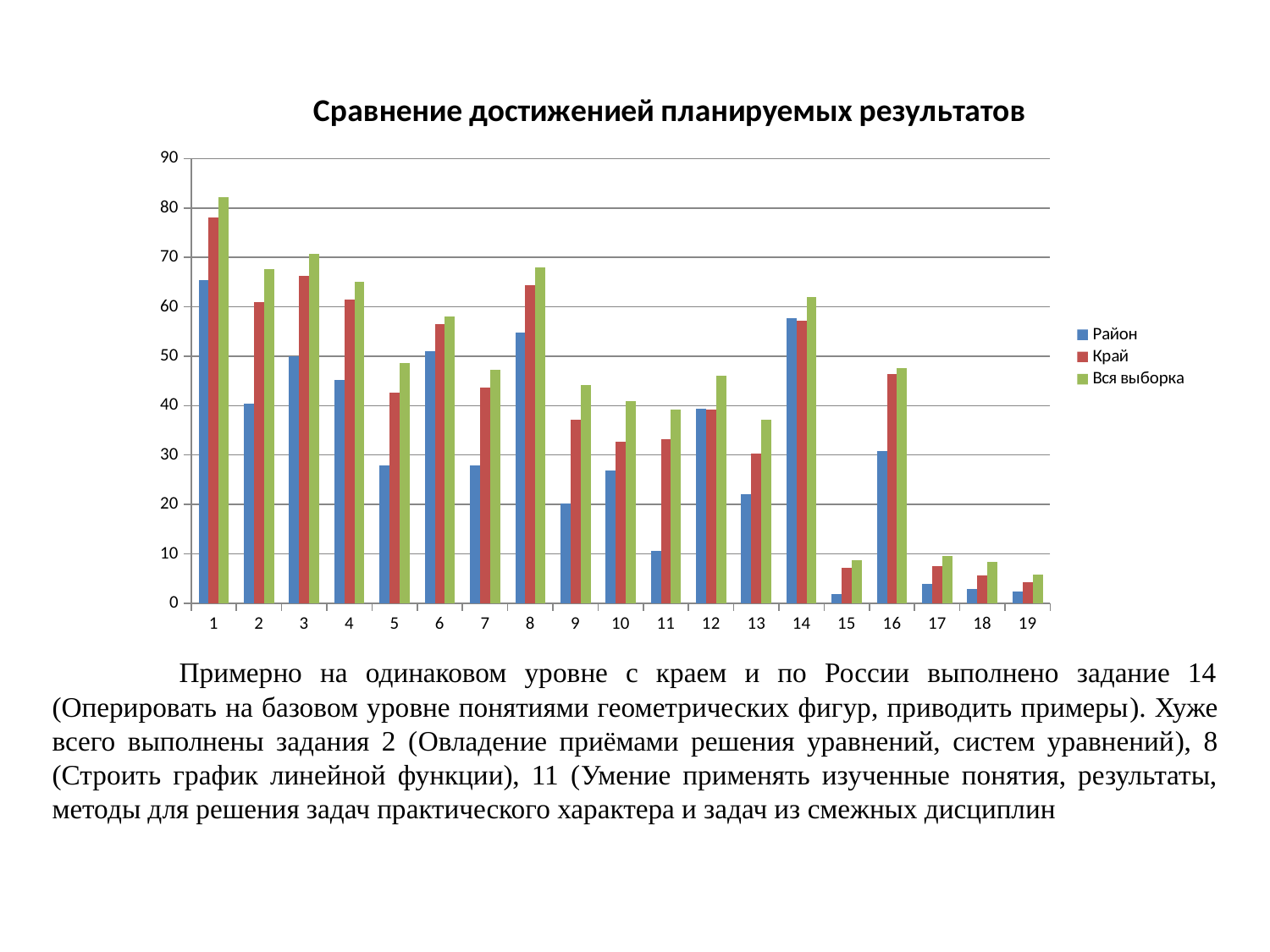
Is the value for Край in category 9 greater or less than 40? less For the series Вся выборка, which category has the highest value? 1 How many series does the legend list? 3 For the series Вся выборка, which category has the lowest value? 19 What is the title of the chart? Сравнение достиженией планируемых результатов For the series Район, which category has the lowest value? 15 For the series Район, which category has the highest value? 1 Is the value for Район in category 1 greater or less than 60? greater Is the value for Район in category 11 greater or less than 20? less In category 16, which is larger: Район or Вся выборка? Вся выборка How many categories are shown on the x axis? 19 What kind of chart is shown on the slide? bar chart